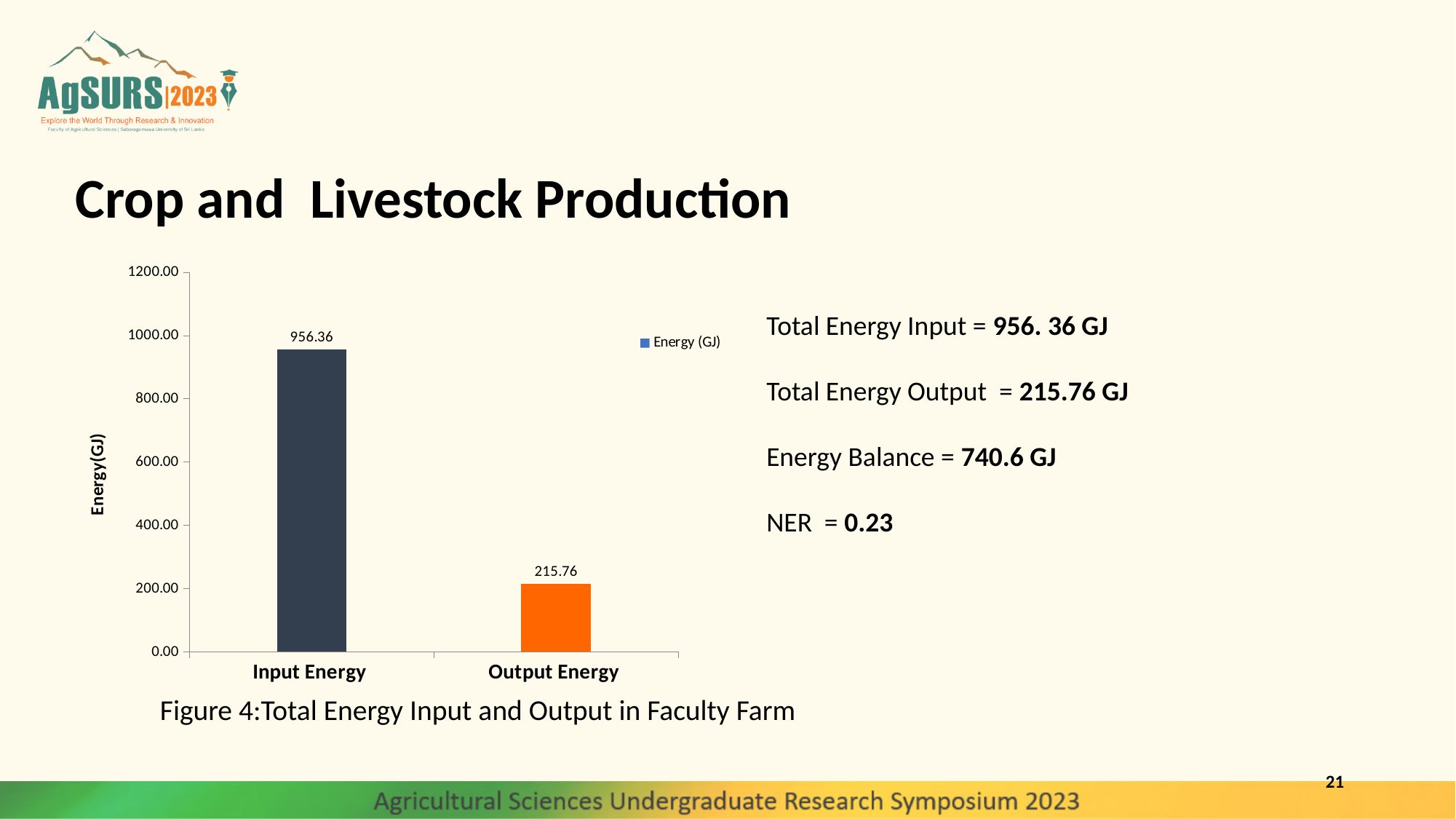
What is the difference between the Input Energy and Output Energy values? 740.6 Is the value for Input Energy greater or less than 800.00? greater What is the value for Output Energy? 215.76 What kind of chart is shown? bar chart Which category has the lowest value? Output Energy How many categories are shown on the x axis? 2 What is the value for Input Energy? 956.36 How many series does the legend list? 1 Is the value for Output Energy greater or less than 400.00? less Which category has the highest value? Input Energy What is the label of the y axis? Energy(GJ) Which is larger, Input Energy or Output Energy? Input Energy